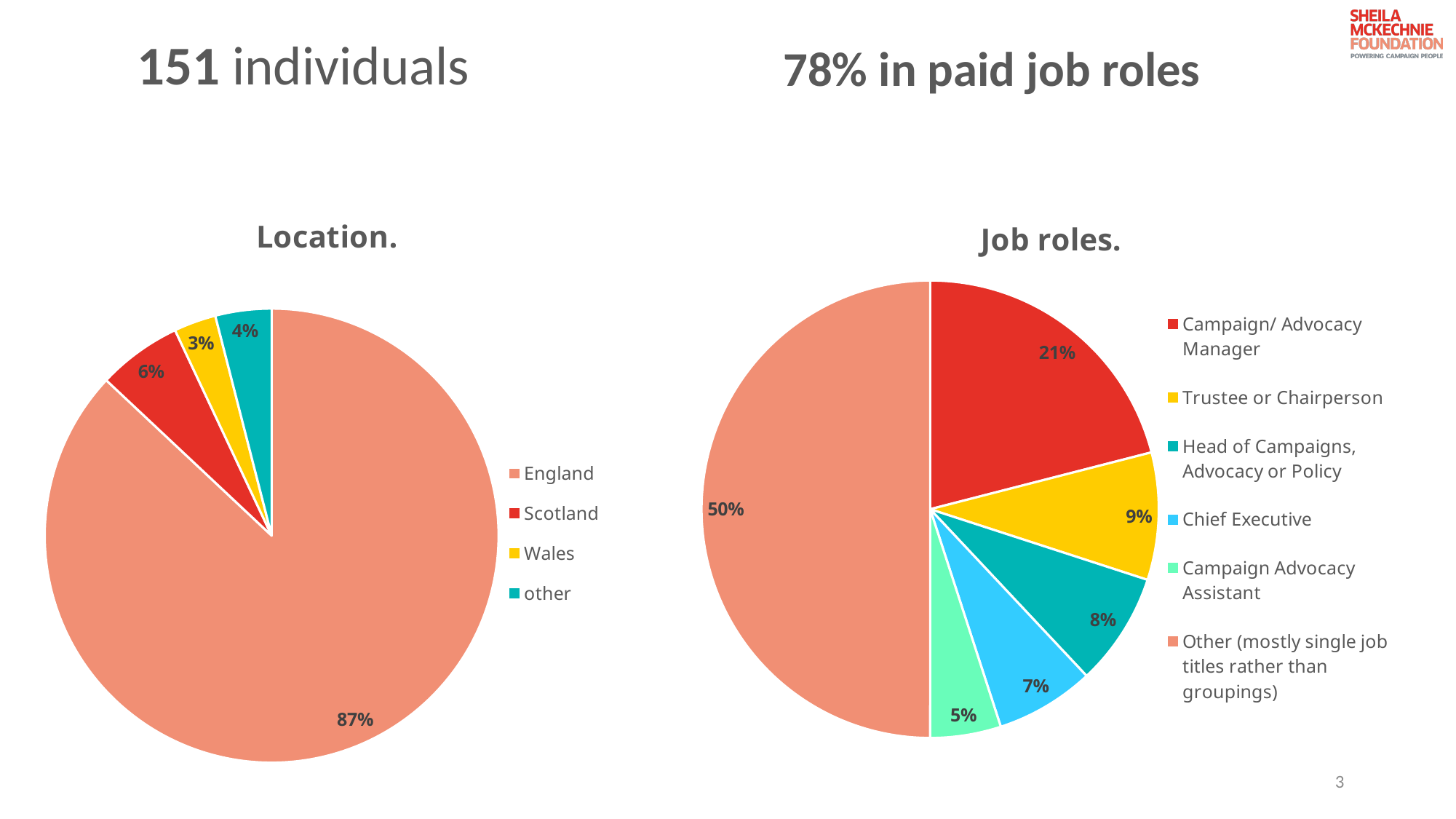
In the 'Job roles.' chart, which category has the largest slice? Other (mostly single job titles rather than groupings) In the 'Job roles.' chart, which is larger: Trustee or Chairperson or Chief Executive? Trustee or Chairperson In the 'Location.' chart, what share of the pie is England? 87% In the 'Job roles.' chart, how many categories does the legend list? 6 In the 'Job roles.' chart, what is the value for Campaign/ Advocacy Manager? 21% In the 'Location.' chart, which category has the smallest slice? Wales In the 'Location.' chart, what is the difference between the Scotland and Wales values? 3% In the 'Job roles.' chart, what is the difference between the Campaign/ Advocacy Manager and Head of Campaigns, Advocacy or Policy values? 13% In the 'Location.' chart, what is the value for Scotland? 6% In the 'Job roles.' chart, what is the value for Campaign Advocacy Assistant? 5% What kind of chart is the 'Job roles.' chart? Pie chart In the 'Location.' chart, how many categories does the legend list? 4